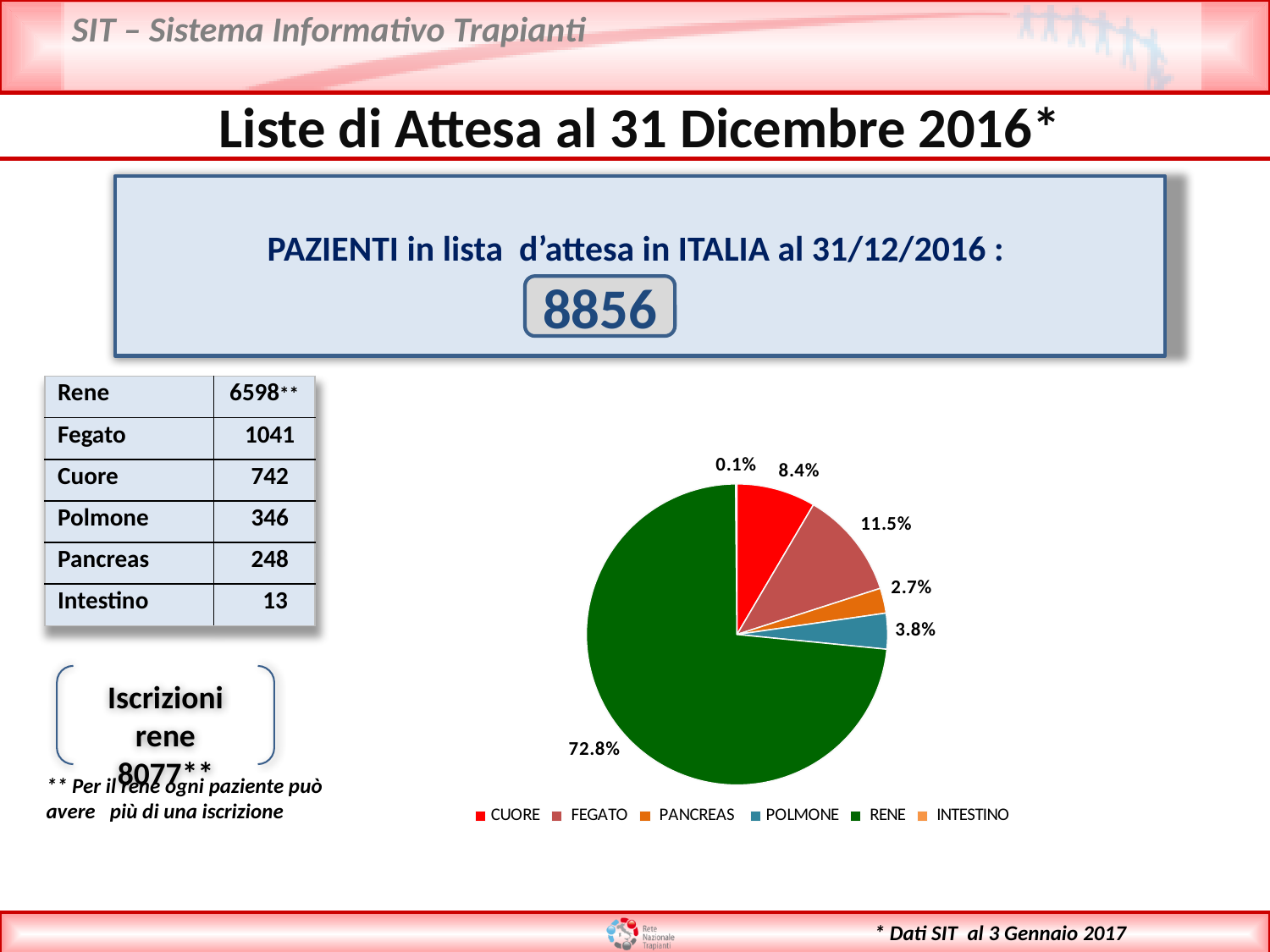
In the pie chart, what share is labelled for RENE? 72.8% What is the difference in percentage points between the FEGATO and CUORE slices? 3.1% In the pie chart, what share is labelled for POLMONE? 3.8% In the pie chart, what share is labelled for PANCREAS? 2.7% What kind of chart is shown on the slide? pie chart How many categories does the pie chart legend list? 6 Which category has the largest slice in the pie chart? RENE What colour is the RENE slice in the pie chart? green In the pie chart, what share is labelled for FEGATO? 11.5% Which slice is larger in the pie chart, POLMONE or PANCREAS? POLMONE In the pie chart, what share is labelled for CUORE? 8.4% Which category has the smallest slice in the pie chart? INTESTINO